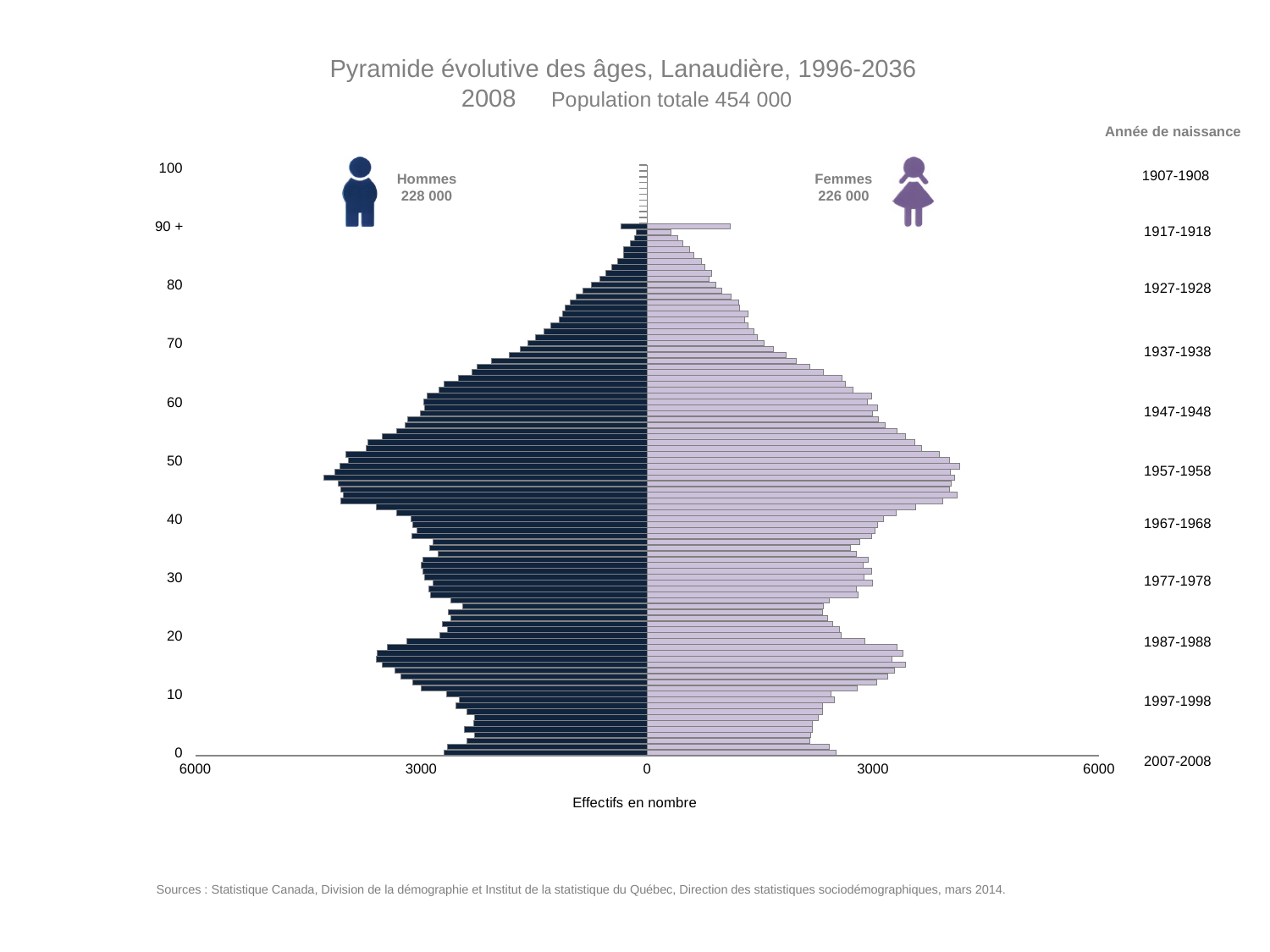
What is the title of the chart? Pyramide évolutive des âges, Lanaudière, 1996-2036 What is the total number of Hommes shown on the chart? 228 000 Is the value for Hommes at around age 47 greater or less than 3000? greater Is the value for Femmes at around age 80 greater or less than 3000? less What kind of chart is shown on the slide? bar chart What is the total number of Femmes shown on the chart? 226 000 Which group has the larger total, Hommes or Femmes? Hommes What is the difference between the Hommes total and the Femmes total? 2 000 Is the value for Femmes at age 90 + greater or less than 3000? less What is the total population shown for 2008? 454 000 How many series (population groups) does the chart show? 2 What is the label of the horizontal axis? Effectifs en nombre